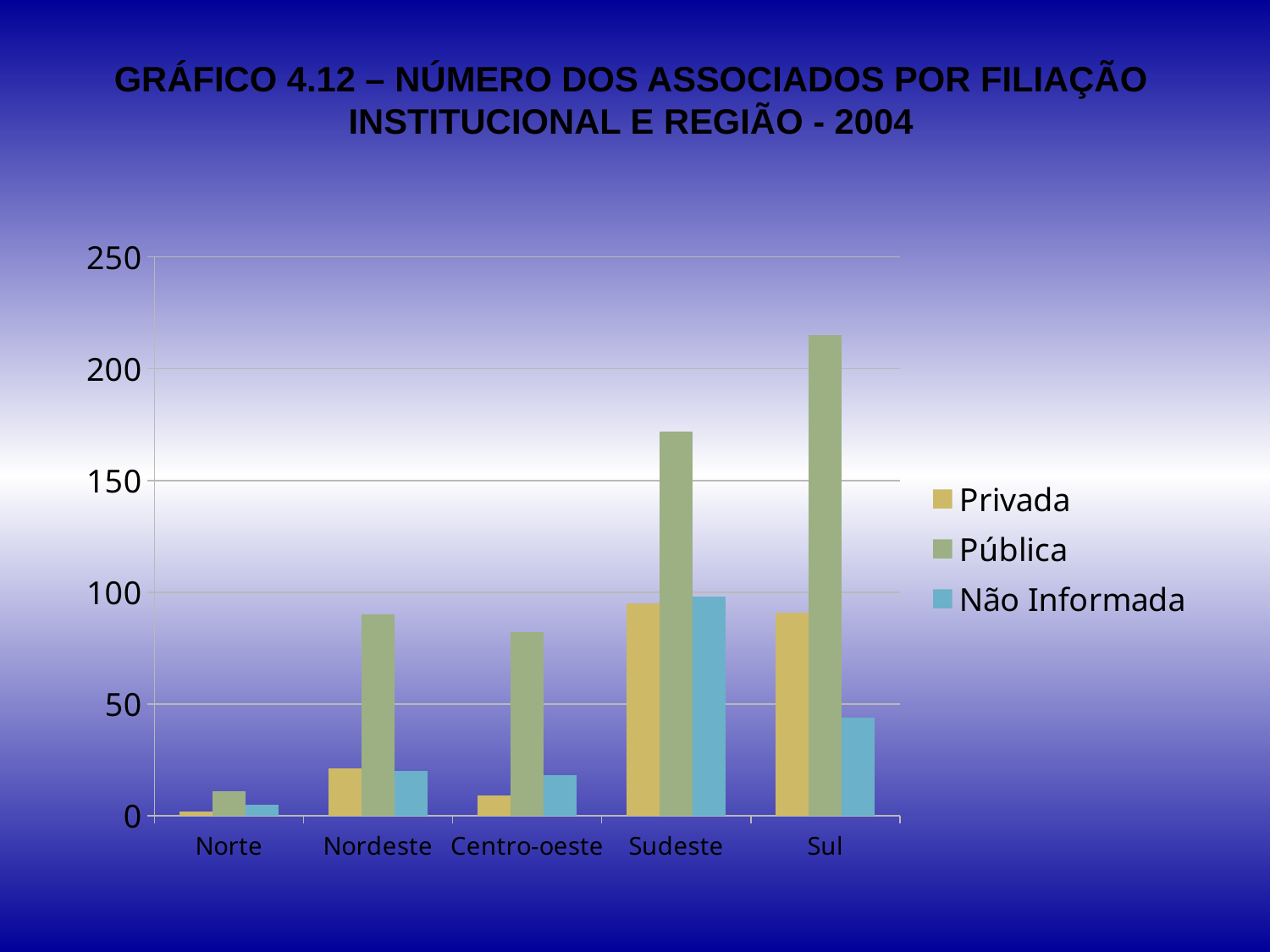
Which region has the highest value for Não Informada? Sudeste Which region has the highest value for Pública? Sul What are the three series listed in the legend? Privada, Pública, Não Informada How many series does the legend list? 3 What kind of chart is shown on the slide? bar chart Is the Privada value for Sudeste greater or less than 100? less Is the Pública value for Sudeste greater or less than 150? greater Is the Pública value for Sul greater or less than 200? greater Which region has the lowest value for Pública? Norte How many regions are shown on the x axis of the chart? 5 Which is larger, the Privada value for Nordeste or the Privada value for Centro-oeste? Nordeste